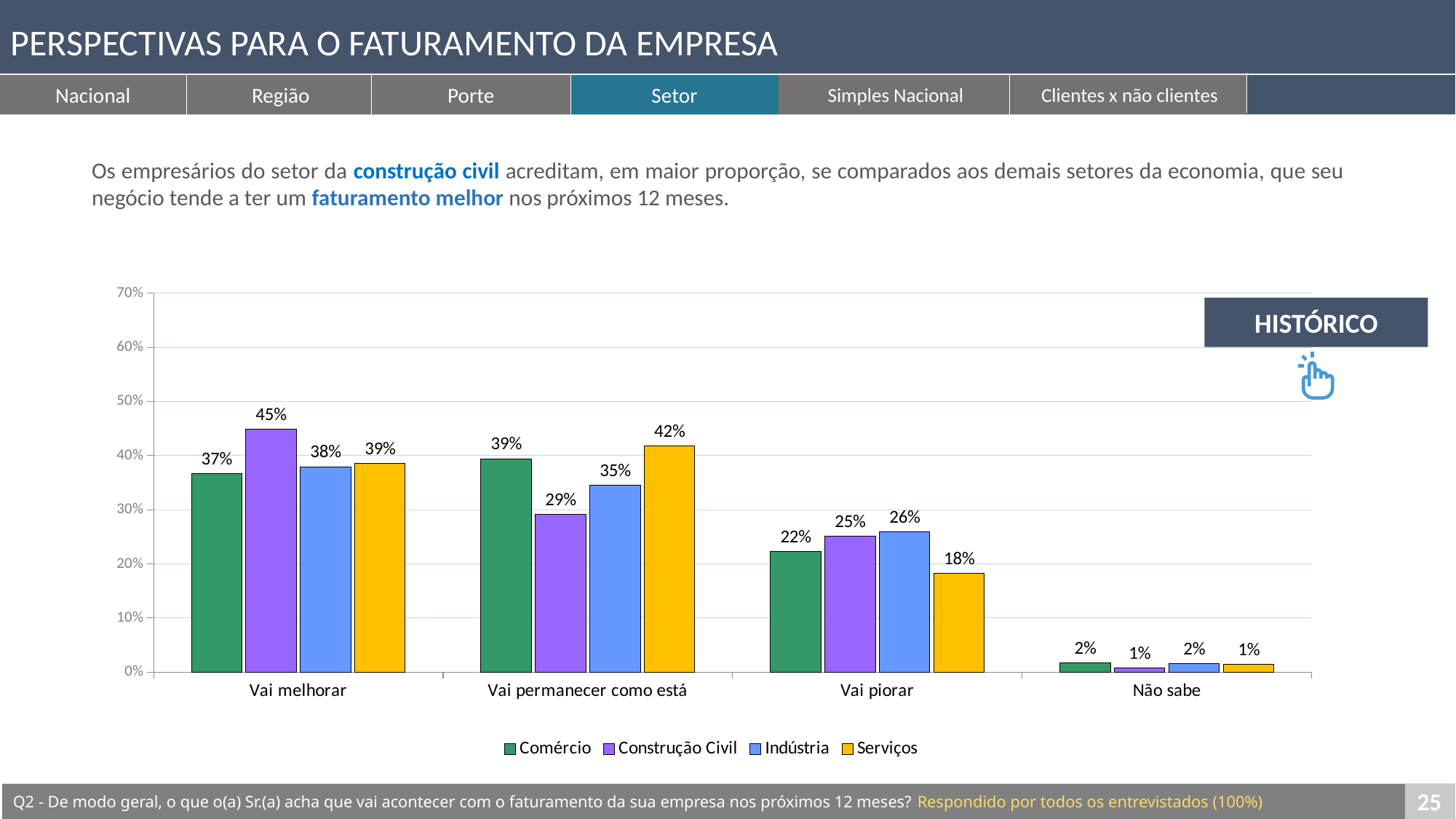
What kind of chart is shown on the slide? Bar chart What is the value for Serviços in the 'Vai permanecer como está' category? 42% Which colour represents Serviços in the legend? Yellow How many series does the legend list? 4 Which series has the highest value in the 'Vai melhorar' category? Construção Civil What is the difference between Construção Civil and Comércio in the 'Vai melhorar' category? 8% What is the value for Construção Civil in the 'Vai melhorar' category? 45% What is the value for Indústria in the 'Não sabe' category? 2% What is the value for Comércio in the 'Vai piorar' category? 22% Which is larger in the 'Vai permanecer como está' category: Comércio or Construção Civil? Comércio How many categories are shown on the x axis? 4 Which series has the lowest value in the 'Vai piorar' category? Serviços